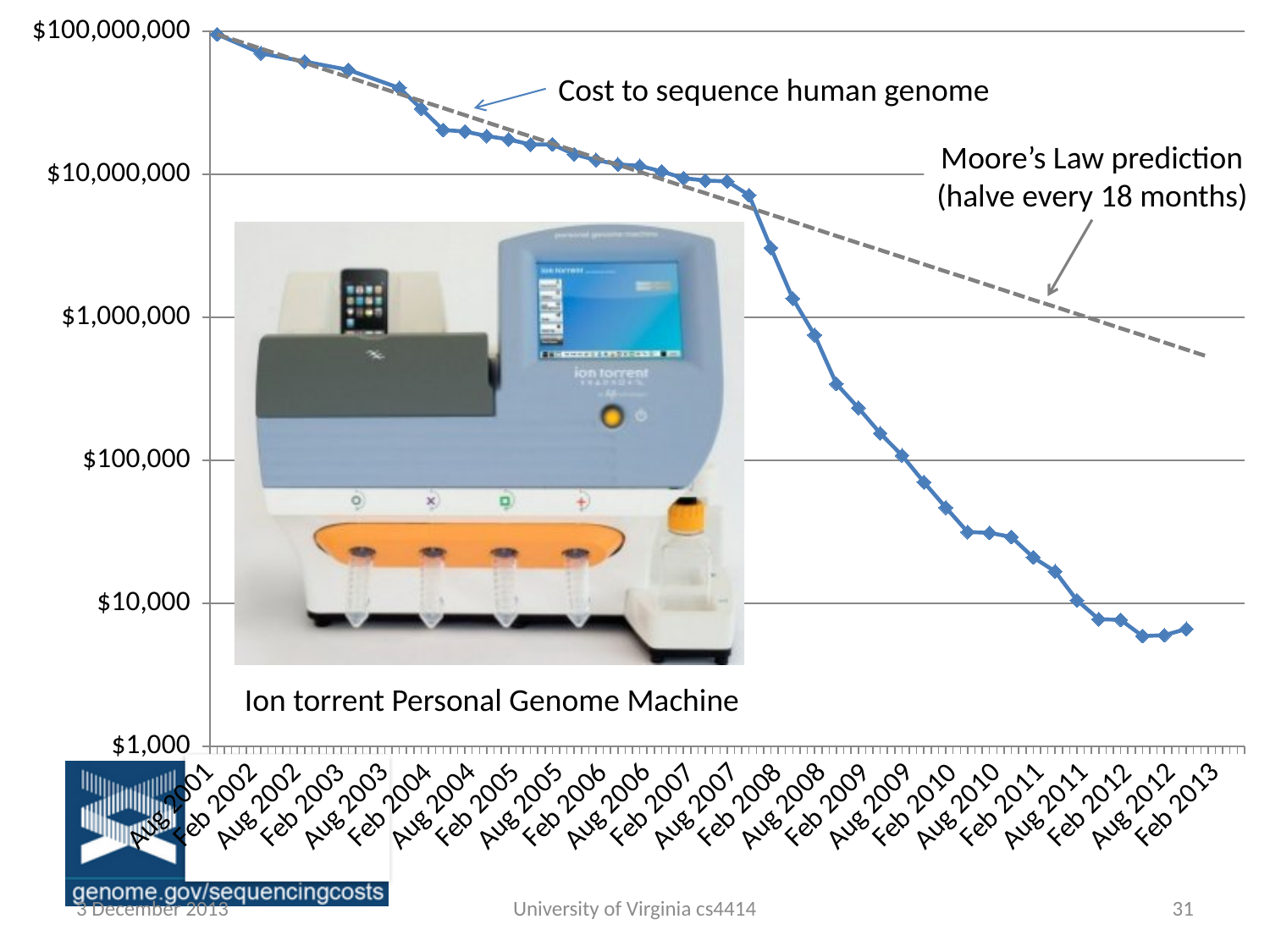
What is the highest value labelled on the y axis? $100,000,000 Does the cost to sequence a human genome rise or fall from Aug 2001 to Feb 2013? fall How many date labels are shown on the x axis? 24 Which is larger: the cost to sequence a human genome in Aug 2001 or in Feb 2013? Aug 2001 Is the cost to sequence a human genome in Feb 2008 greater or less than $1,000,000? greater What does the dashed grey line on the chart represent? Moore's Law prediction (halve every 18 months) Is the cost to sequence a human genome in Aug 2004 greater or less than $10,000,000? greater Is the cost to sequence a human genome in Feb 2010 greater or less than $100,000? less How many lines are plotted on the chart? 2 What kind of chart is shown on the slide? line chart In Feb 2013, which is higher: the Moore's Law prediction or the actual cost to sequence a human genome? Moore's Law prediction